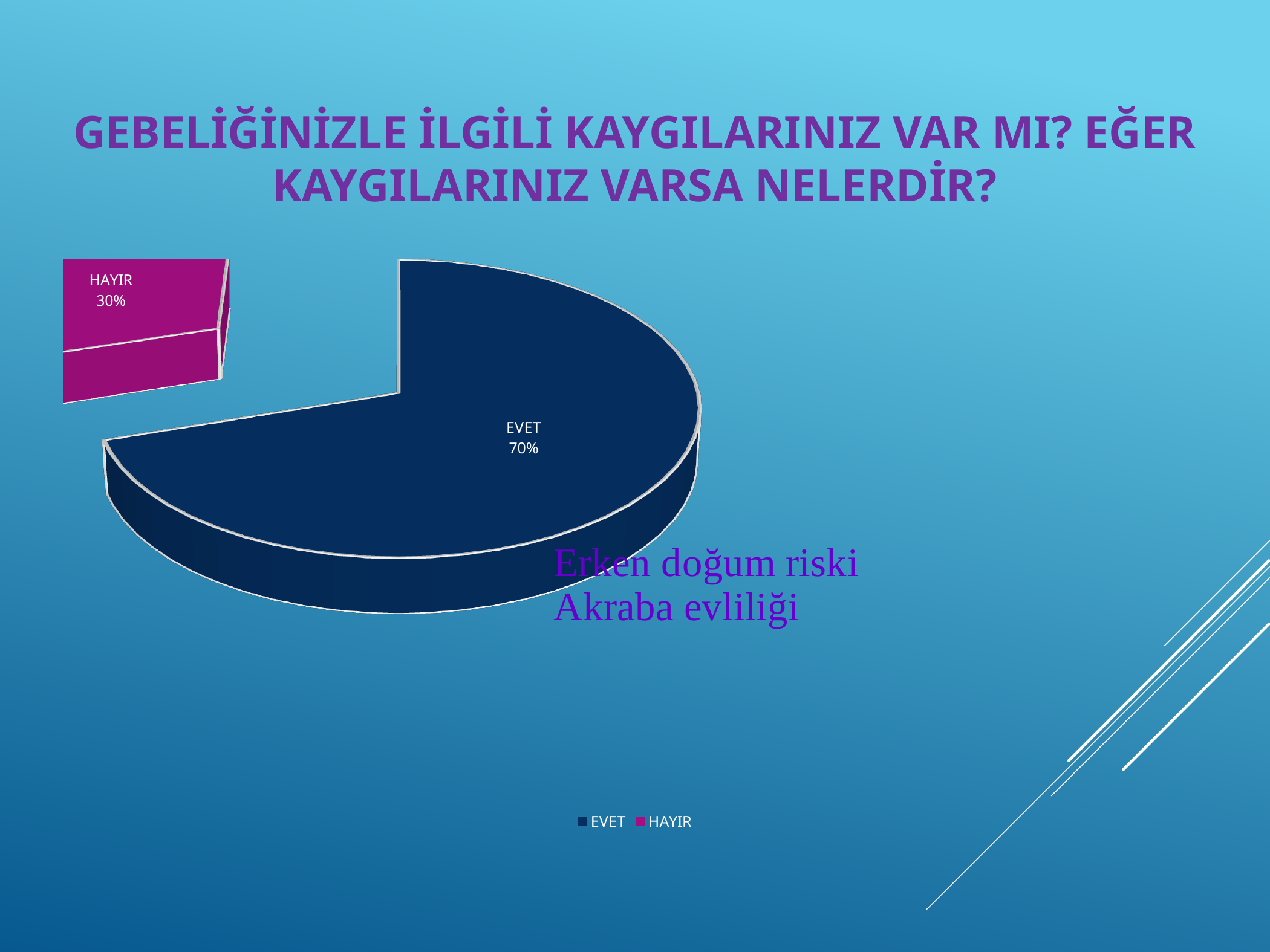
What percentage of the pie chart is labelled HAYIR? 30% What share of the pie does the HAYIR slice represent? 30% Which slice of the pie chart is the largest? EVET Which slice is pulled out (exploded) from the pie chart? HAYIR What colour is the EVET slice of the pie chart? Dark blue What is the difference in percentage points between the EVET and HAYIR slices? 40 Which slice of the pie chart is the smallest? HAYIR How many slices does the pie chart have? 2 What percentage of the pie chart is labelled EVET? 70% How many entries does the legend list? 2 What kind of chart is shown on the slide? Pie chart Which slice is larger, EVET or HAYIR? EVET